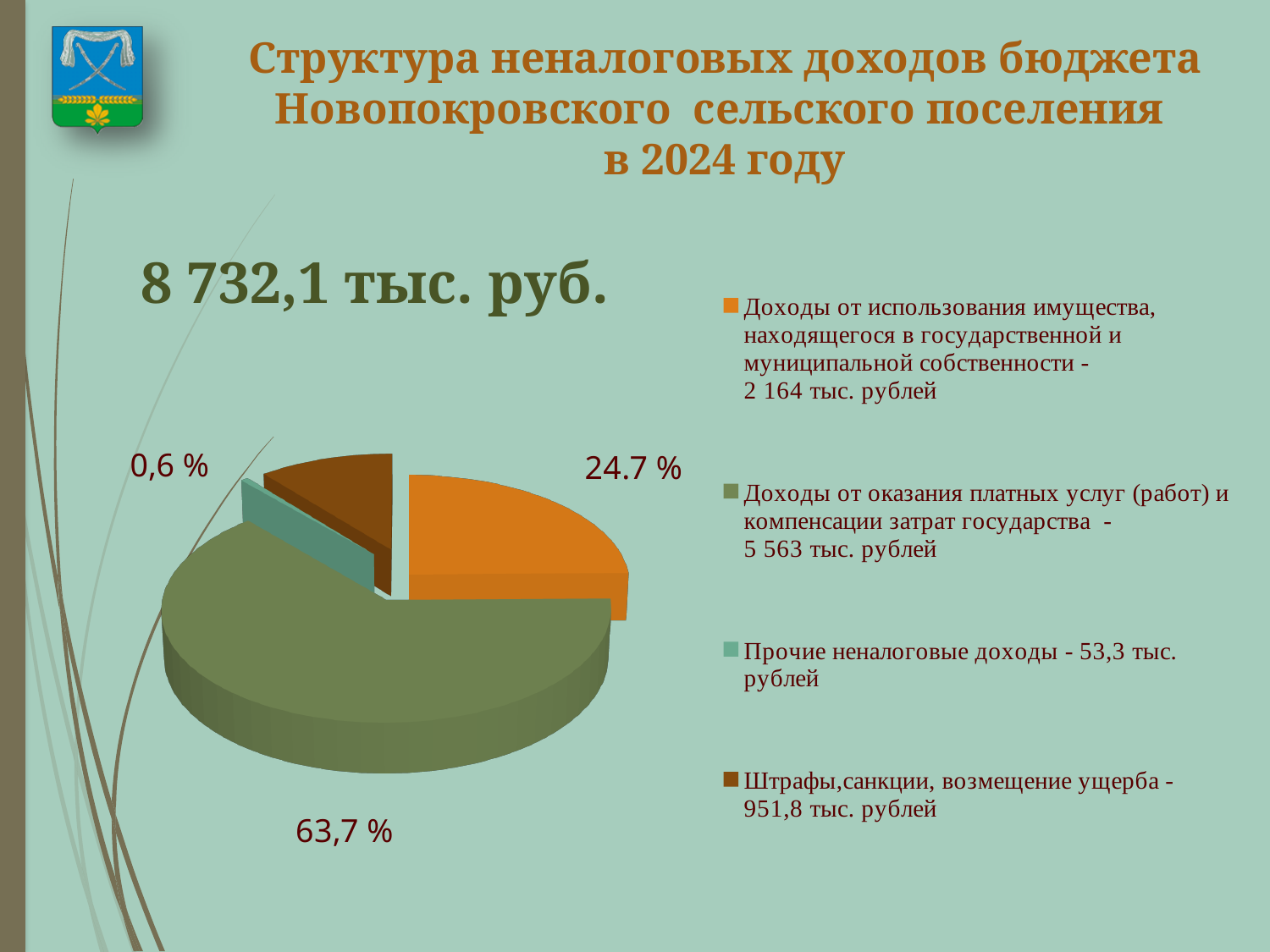
What total amount is printed above the pie chart? 8 732,1 тыс. руб. How many slices does the pie chart have? 4 According to the legend, what is the value for 'Штрафы,санкции, возмещение ущерба'? 951,8 тыс. рублей What kind of chart is shown on the slide? pie chart What percentage share is shown for the slice 'Прочие неналоговые доходы'? 0,6 % How many entries does the chart legend list? 4 According to the legend, what is the value for 'Доходы от оказания платных услуг (работ) и компенсации затрат государства'? 5 563 тыс. рублей Which category has the smallest slice of the pie? Прочие неналоговые доходы Which is larger: the slice for 'Доходы от использования имущества' or the slice for 'Штрафы,санкции, возмещение ущерба'? Доходы от использования имущества Which category has the largest slice of the pie? Доходы от оказания платных услуг (работ) и компенсации затрат государства What percentage share is shown for the slice 'Доходы от оказания платных услуг (работ) и компенсации затрат государства'? 63,7 % What percentage share is shown for the slice 'Доходы от использования имущества, находящегося в государственной и муниципальной собственности'? 24.7 %